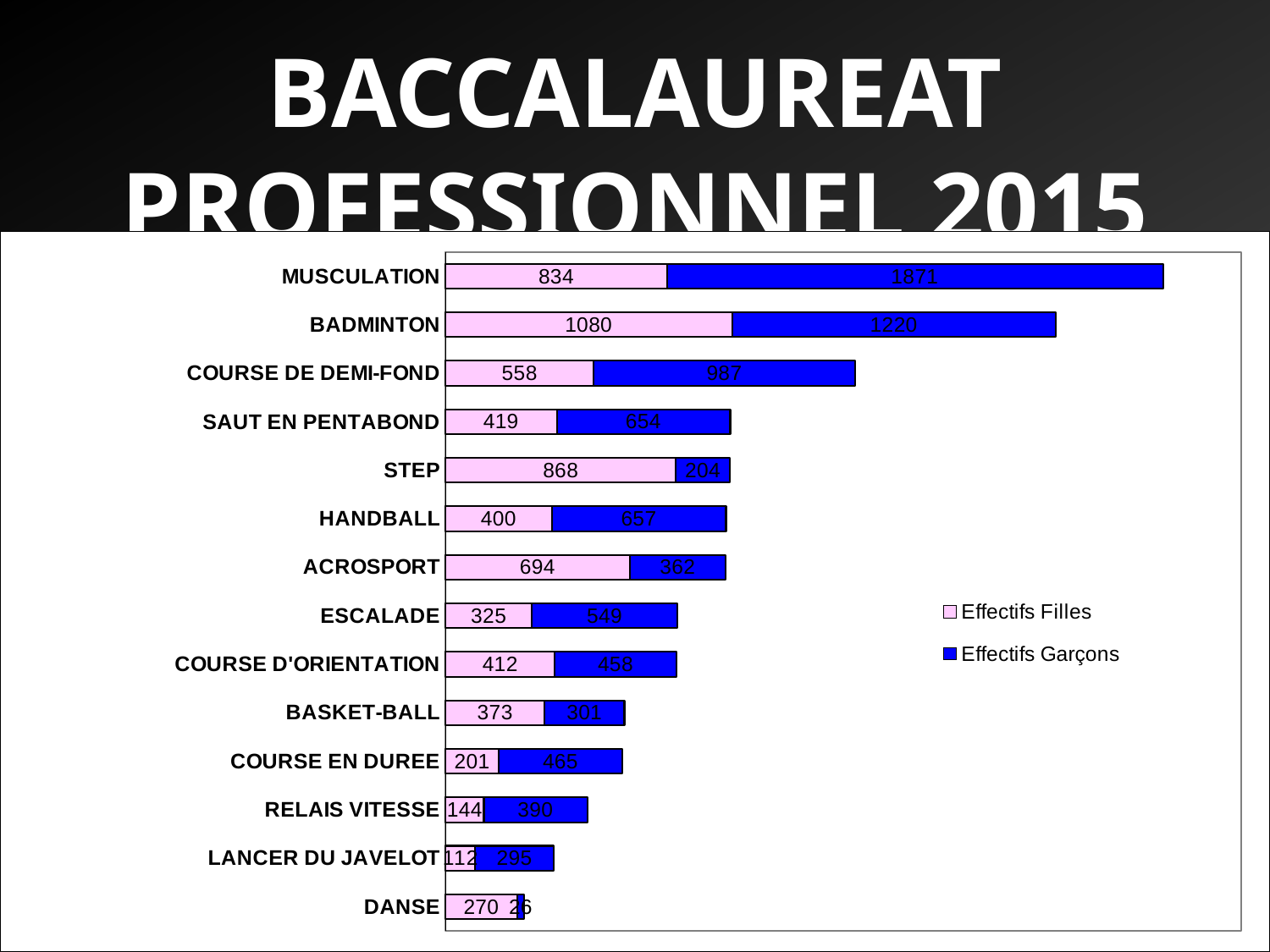
What is the difference between the Effectifs Garçons and Effectifs Filles values for MUSCULATION? 1037 What is the total of the stacked bar for COURSE DE DEMI-FOND? 1545 What is the Effectifs Filles value for STEP? 868 How many series does the legend list? 2 Which category has the lowest Effectifs Filles value? LANCER DU JAVELOT Which is larger for ACROSPORT, the Effectifs Filles value or the Effectifs Garçons value? Effectifs Filles What is the Effectifs Garçons value for RELAIS VITESSE? 390 What is the Effectifs Filles value for BADMINTON? 1080 What is the Effectifs Garçons value for MUSCULATION? 1871 What kind of chart is shown on the slide? bar chart Which category has the highest Effectifs Garçons value? MUSCULATION How many activity categories are plotted on the chart? 14